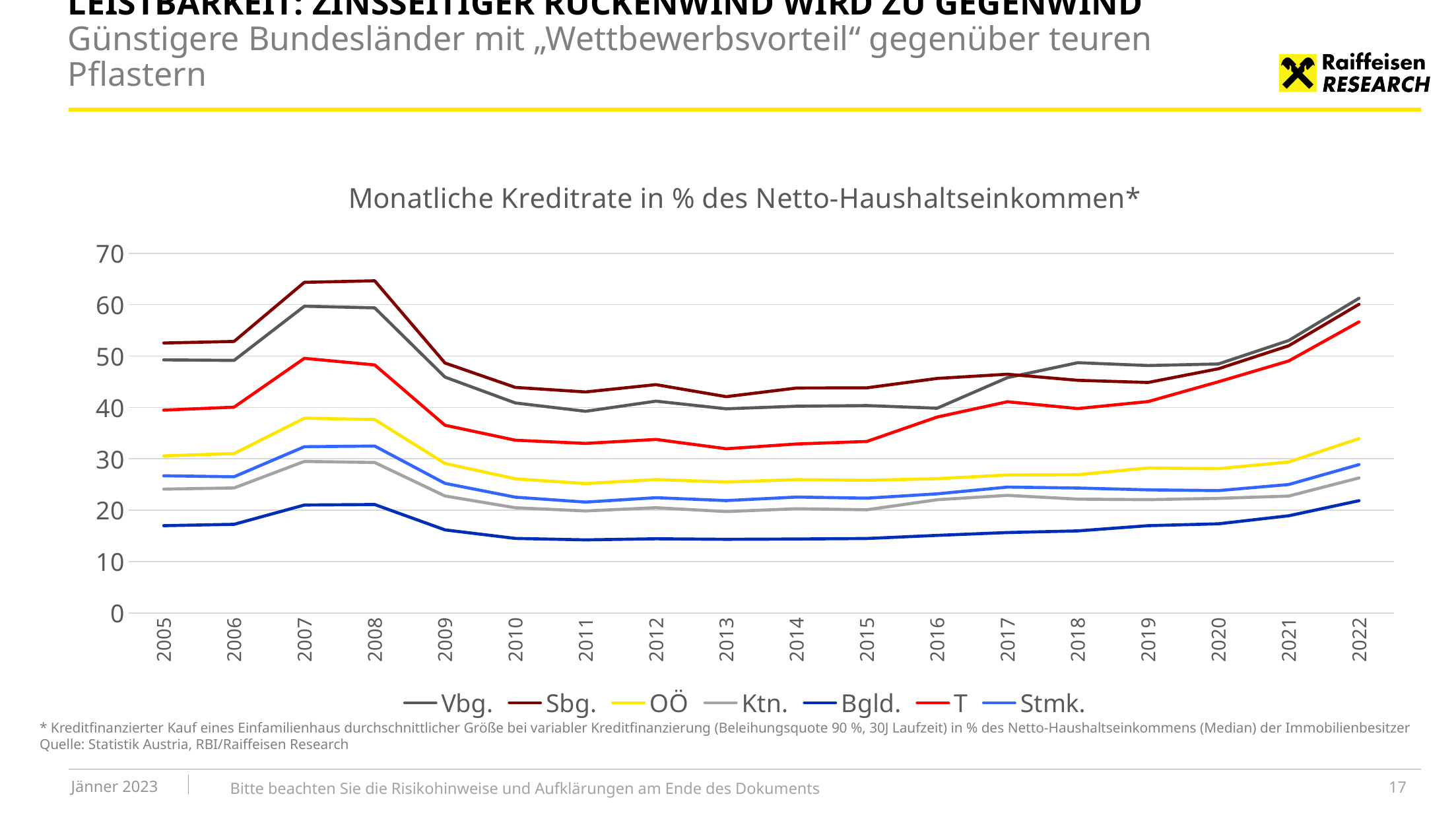
Is the value for Sbg. in 2008 greater or less than 60? greater What is the title of the chart? Monatliche Kreditrate in % des Netto-Haushaltseinkommen* How many series does the legend list? 7 In 2005, which is larger: the value for Sbg. or the value for T? Sbg. Is the value for Bgld. in 2011 greater or less than 20? less Does the value for Bgld. rise or fall from 2016 to 2022? rise Which series has the highest value in 2008? Sbg. How many years are shown on the x axis? 18 Which series has the highest value in 2018? Vbg. Which series has the lowest value in 2022? Bgld. Is the value for OÖ in 2007 greater or less than 40? less What kind of chart is shown on the slide? line chart